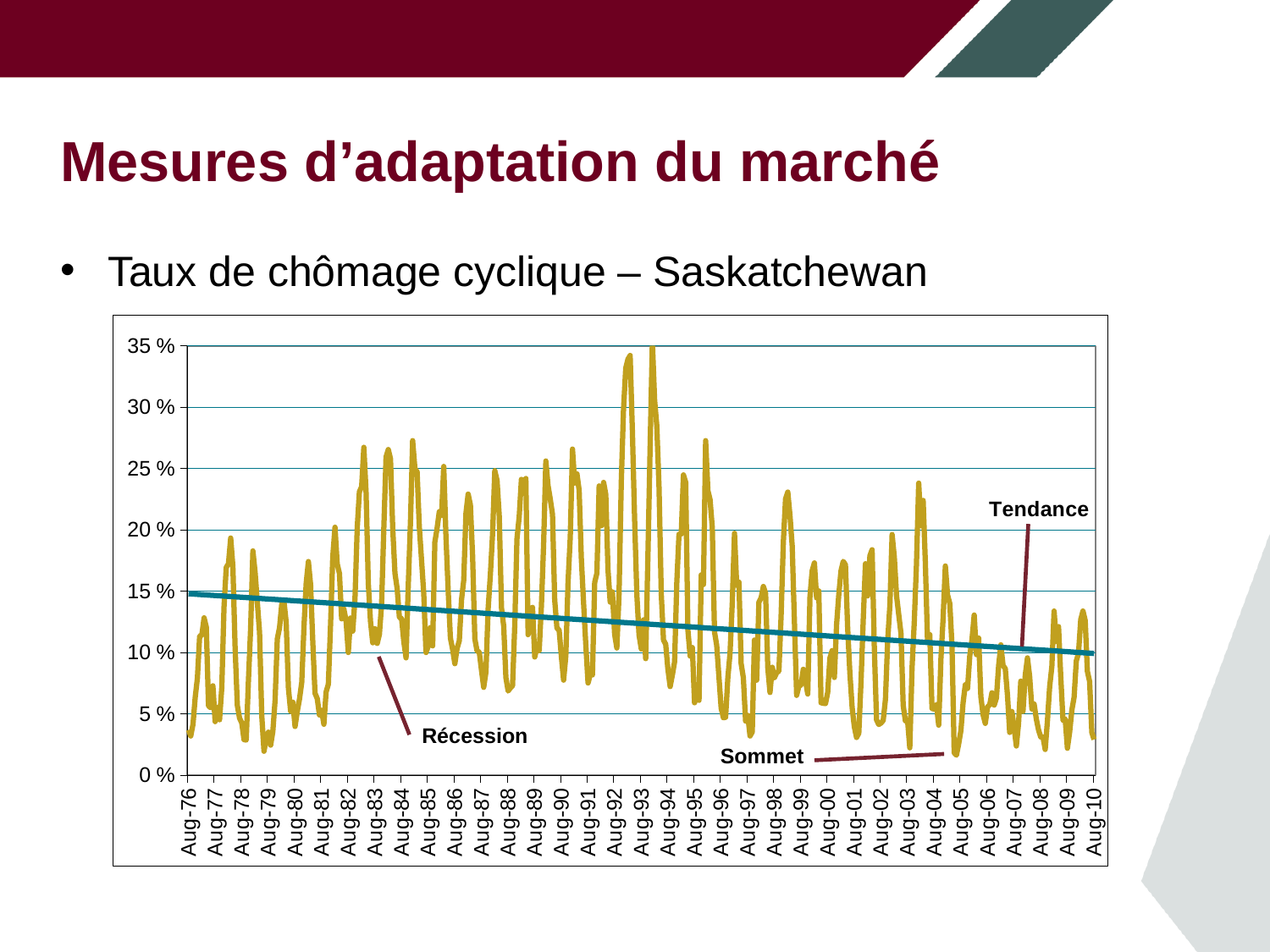
Is the peak of the cyclical unemployment rate near Aug-93 greater or less than 30 %? greater Which province's cyclical unemployment rate does the chart show? Saskatchewan What is the first label on the horizontal axis of the chart? Aug-76 What is the last label on the horizontal axis of the chart? Aug-10 What is the highest value shown on the vertical axis of the chart? 35 % Does the line labelled "Tendance" rise or fall from Aug-76 to Aug-10? Fall What kind of chart is shown on the slide? Line chart Is the value of the "Tendance" line at Aug-93 greater or less than 15 %? less Is the peak of the cyclical unemployment rate near Aug-84 greater or less than 25 %? greater How many labels are shown on the horizontal axis of the chart? 35 How many tick labels are shown on the vertical axis of the chart? 8